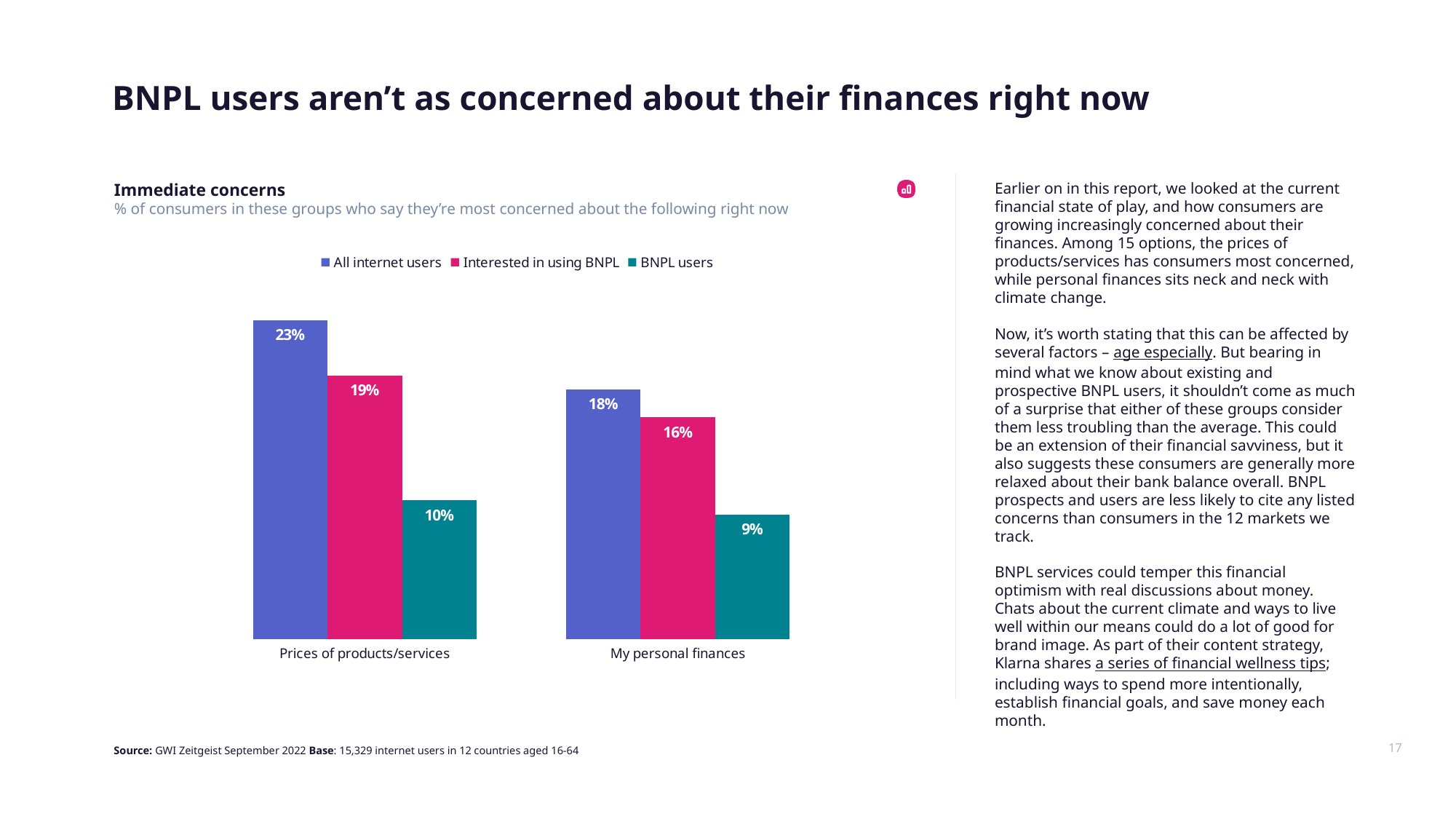
What is the difference between 'Interested in using BNPL' and 'BNPL users' for 'My personal finances'? 7 percentage points Which is larger: all internet users for prices of products/services or all internet users for my personal finances? Prices of products/services What is the difference between all internet users and BNPL users for prices of products/services? 13 percentage points How many categories are shown on the x axis? 2 What is the value for BNPL users for 'My personal finances'? 9% What percentage of all internet users say they are most concerned about prices of products/services? 23% What is the value for 'Interested in using BNPL' for prices of products/services? 19% How many series does the legend list? 3 Which series has the lowest value for prices of products/services? BNPL users Which series has the highest value for 'My personal finances'? All internet users What kind of chart is shown on the slide? Bar chart What is the title of the chart? Immediate concerns